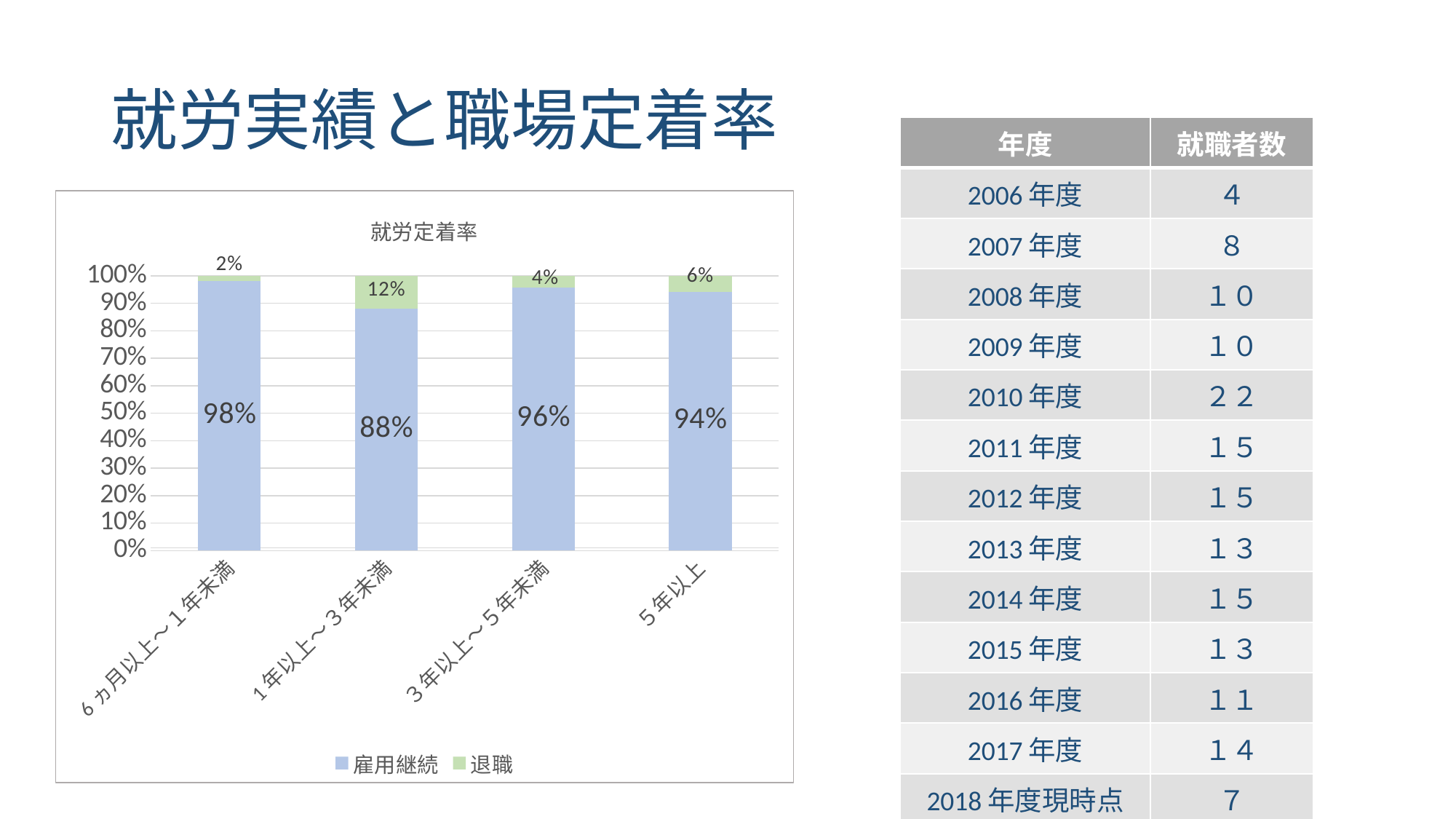
Which is larger, the 退職 value for 5年以上 or for 3年以上～5年未満? 5年以上 What is the difference between the 雇用継続 values for 6カ月以上～1年未満 and 1年以上～3年未満? 10% How many categories are shown on the x axis of the chart? 4 What kind of chart is shown on the slide? Stacked bar chart Which category has the highest 退職 value? 1年以上～3年未満 What is the 雇用継続 value for 5年以上? 94% What is the 退職 value for 3年以上～5年未満? 4% Which category has the lowest 雇用継続 value? 1年以上～3年未満 What is the title of the chart? 就労定着率 What is the 退職 value for 1年以上～3年未満? 12% What is the 雇用継続 value for 6カ月以上～1年未満? 98% How many series does the chart legend list? 2